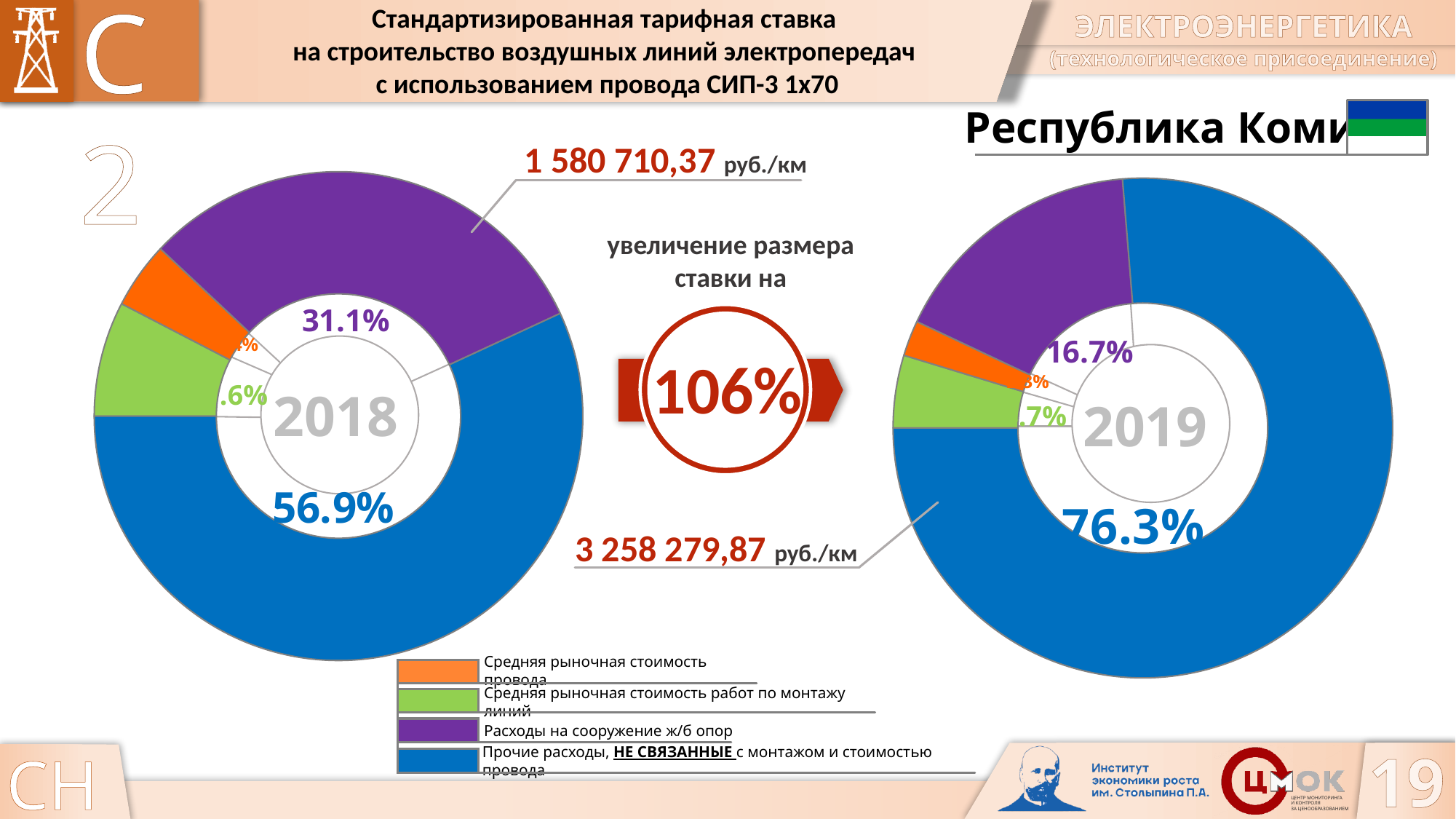
Which is larger: the blue share in the 2018 chart or the blue share in the 2019 chart? 2019 (76.3%) How many categories does the legend list? 4 In the 2018 donut chart, what share is shown for 'Расходы на сооружение ж/б опор' (purple)? 31.1% What tariff rate in руб./км is shown for the 2018 chart? 1 580 710,37 руб./км What is the difference between the purple share in 2018 (31.1%) and in 2019 (16.7%)? 14.4 percentage points In the 2019 donut chart, which category has the largest share? Прочие расходы, НЕ СВЯЗАННЫЕ с монтажом и стоимостью провода What tariff rate in руб./км is shown for the 2019 chart? 3 258 279,87 руб./км In the 2019 donut chart, what share is shown for 'Расходы на сооружение ж/б опор' (purple)? 16.7% In the 2018 donut chart, which category has the largest share? Прочие расходы, НЕ СВЯЗАННЫЕ с монтажом и стоимостью провода What type of charts are shown on the slide? Donut (pie) charts In the 2019 donut chart, what share is shown for 'Прочие расходы, НЕ СВЯЗАННЫЕ с монтажом и стоимостью провода' (blue)? 76.3%